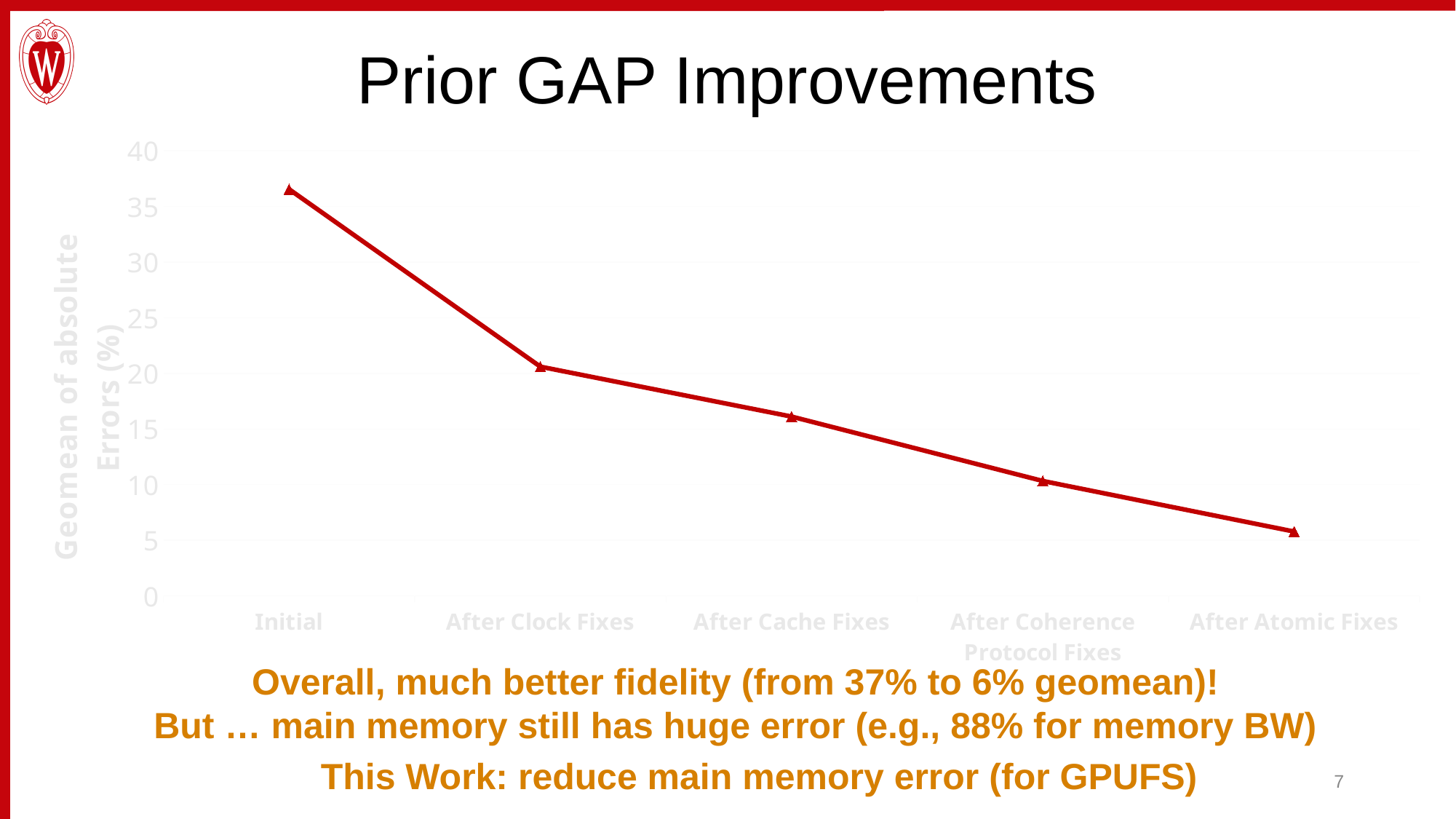
Is the value for After Cache Fixes greater or less than 20? less Is the value for After Atomic Fixes greater or less than 10? less How many categories are plotted along the x axis? 5 Which is larger, the value for After Clock Fixes or the value for After Coherence Protocol Fixes? After Clock Fixes Which category has the highest geomean of absolute errors? Initial Which category has the lowest geomean of absolute errors? After Atomic Fixes Is the value for Initial greater or less than 35? greater What kind of chart is shown on the slide? line chart What is the label of the y axis? Geomean of absolute Errors (%) Do the values rise or fall from left to right along the x axis? fall